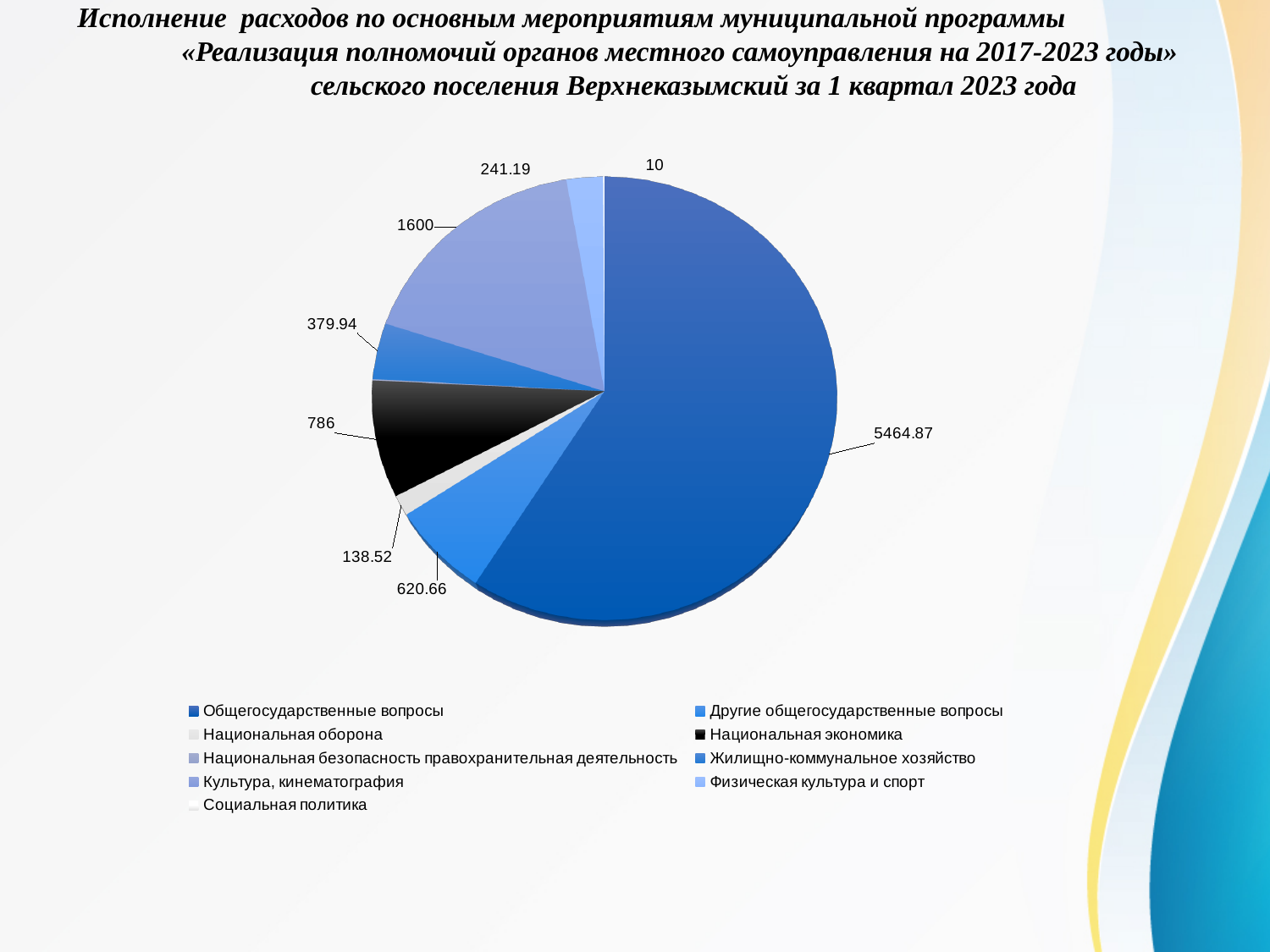
What is the difference between the values for Культура, кинематография and Национальная экономика? 814 What is the smallest value labelled on the pie chart? 10 What is the value for Национальная экономика? 786 What is the value for Национальная оборона? 138.52 What is the largest value shown on the pie chart? 5464.87 How many data labels are printed on the pie chart? 8 Which is larger, Национальная экономика or Национальная оборона? Национальная экономика Which legend entry is shown in black? Национальная экономика What type of chart is shown on the slide? pie chart What is the value for Общегосударственные вопросы? 5464.87 What is the value for Культура, кинематография? 1600 How many entries does the legend list? 9